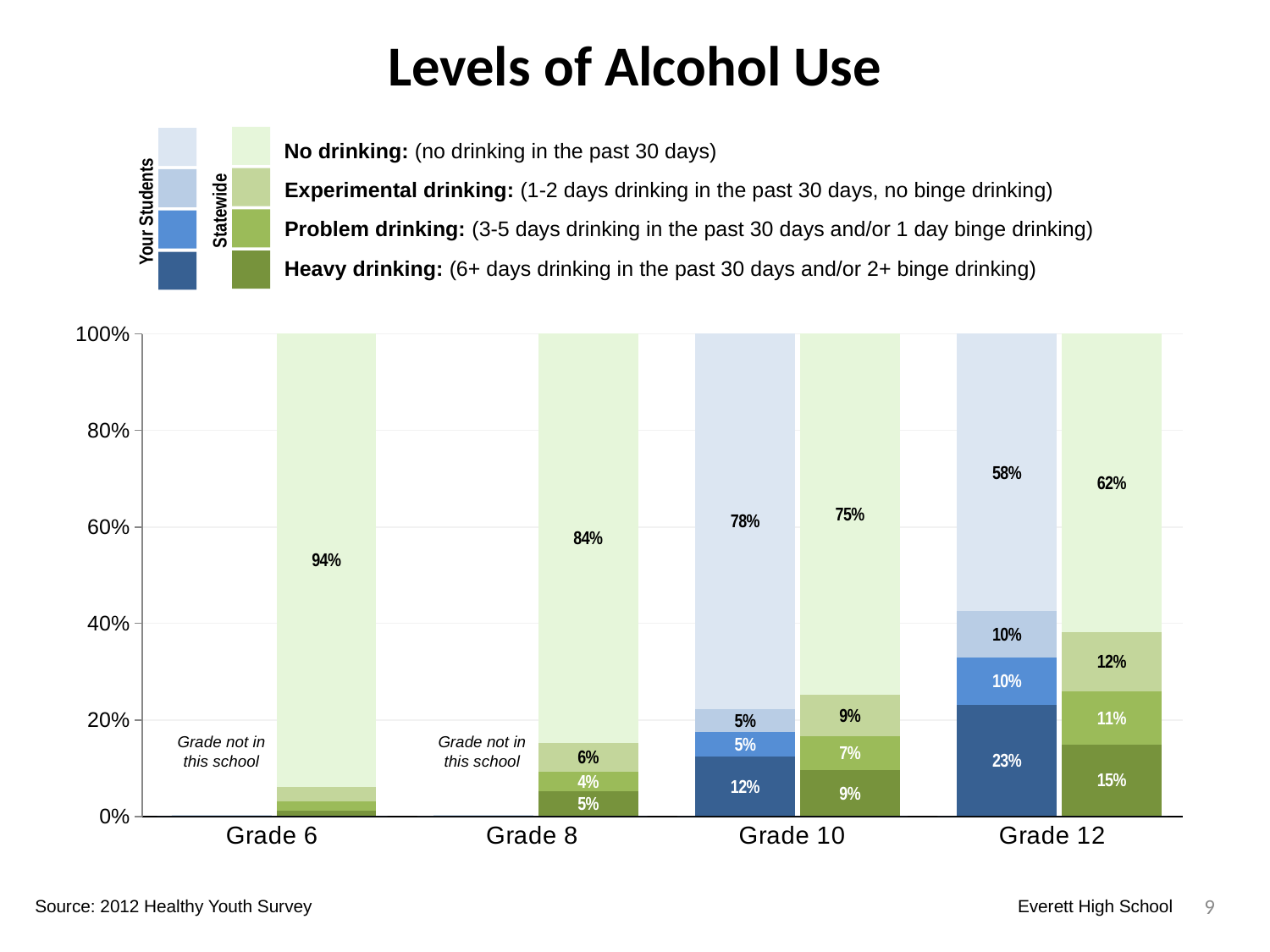
Which grade has the lowest statewide no drinking percentage? Grade 12 What is the statewide experimental drinking percentage for Grade 10? 9% What is the statewide heavy drinking percentage for Grade 8? 5% What is the statewide no drinking percentage for Grade 6? 94% For Grade 10, is the heavy drinking percentage higher for Your Students or Statewide? Your Students What is the difference between the Grade 12 statewide no drinking percentage and the Grade 12 Your Students no drinking percentage? 4% What is the no drinking percentage for Grade 10 Your Students? 78% How many grade categories are shown on the x axis? 4 Does the statewide no drinking percentage rise or fall from Grade 6 to Grade 12? fall What percentage of Grade 12 Your Students fall into the heavy drinking category? 23% What kind of chart is shown on the slide? stacked bar chart Which grades are marked as 'Grade not in this school' for Your Students? Grade 6 and Grade 8